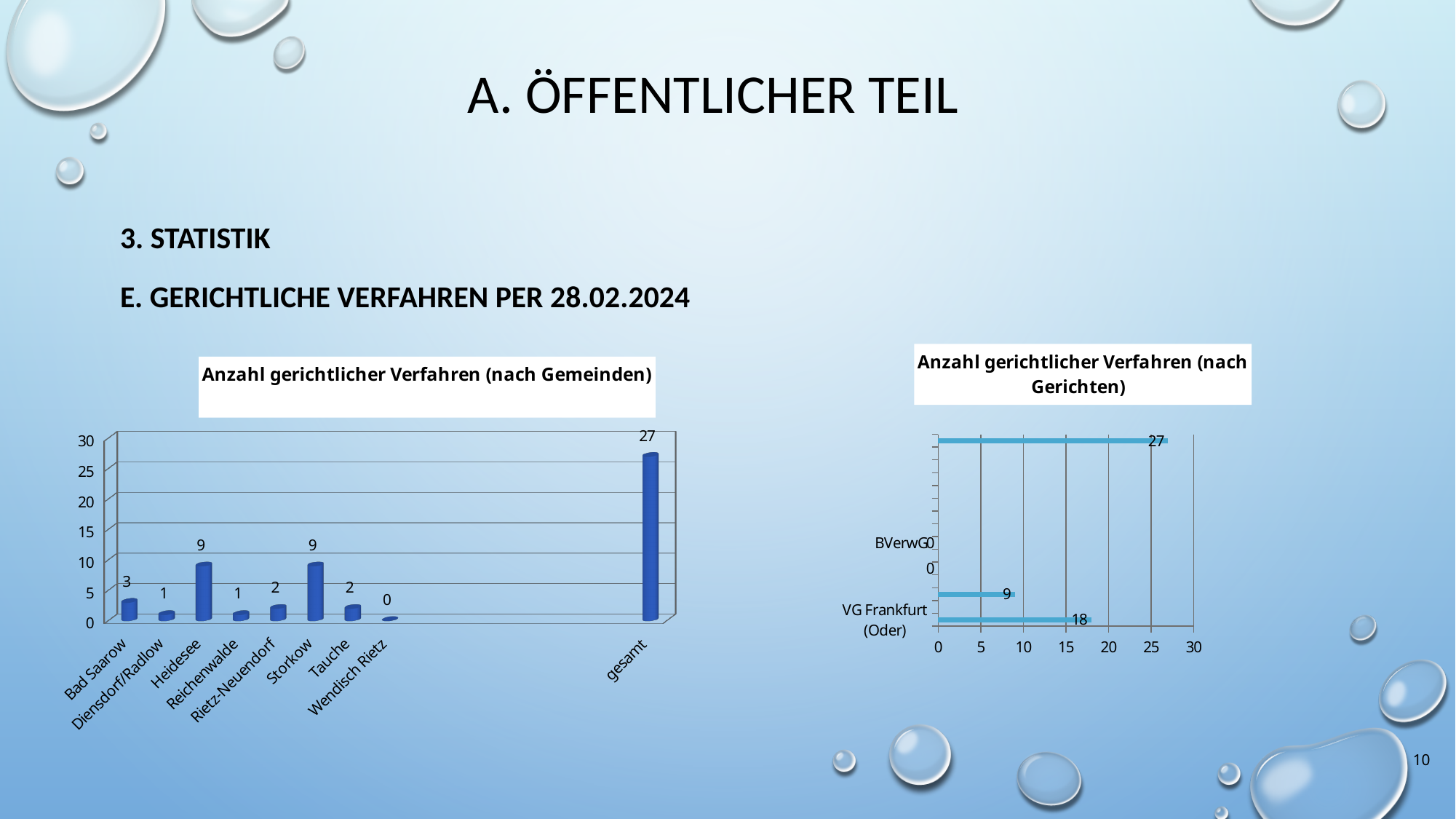
In the chart 'Anzahl gerichtlicher Verfahren (nach Gemeinden)', what is the difference between the values for Heidesee and Bad Saarow? 6 In the chart 'Anzahl gerichtlicher Verfahren (nach Gemeinden)', what is the value for gesamt? 27 In the chart 'Anzahl gerichtlicher Verfahren (nach Gerichten)', what kind of chart is shown? bar chart In the chart 'Anzahl gerichtlicher Verfahren (nach Gemeinden)', what is the value for Bad Saarow? 3 In the chart 'Anzahl gerichtlicher Verfahren (nach Gemeinden)', which Gemeinde has the lowest value? Wendisch Rietz In the chart 'Anzahl gerichtlicher Verfahren (nach Gemeinden)', what is the value for Rietz-Neuendorf? 2 In the chart 'Anzahl gerichtlicher Verfahren (nach Gerichten)', what is the value for BVerwG? 0 In the chart 'Anzahl gerichtlicher Verfahren (nach Gemeinden)', what is the value for Heidesee? 9 In the chart 'Anzahl gerichtlicher Verfahren (nach Gemeinden)', how many categories are shown on the x axis? 9 In the chart 'Anzahl gerichtlicher Verfahren (nach Gerichten)', what is the largest value printed on a bar? 27 In the chart 'Anzahl gerichtlicher Verfahren (nach Gemeinden)', which is larger, the value for Storkow or the value for Tauche? Storkow In the chart 'Anzahl gerichtlicher Verfahren (nach Gemeinden)', what kind of chart is shown? bar chart